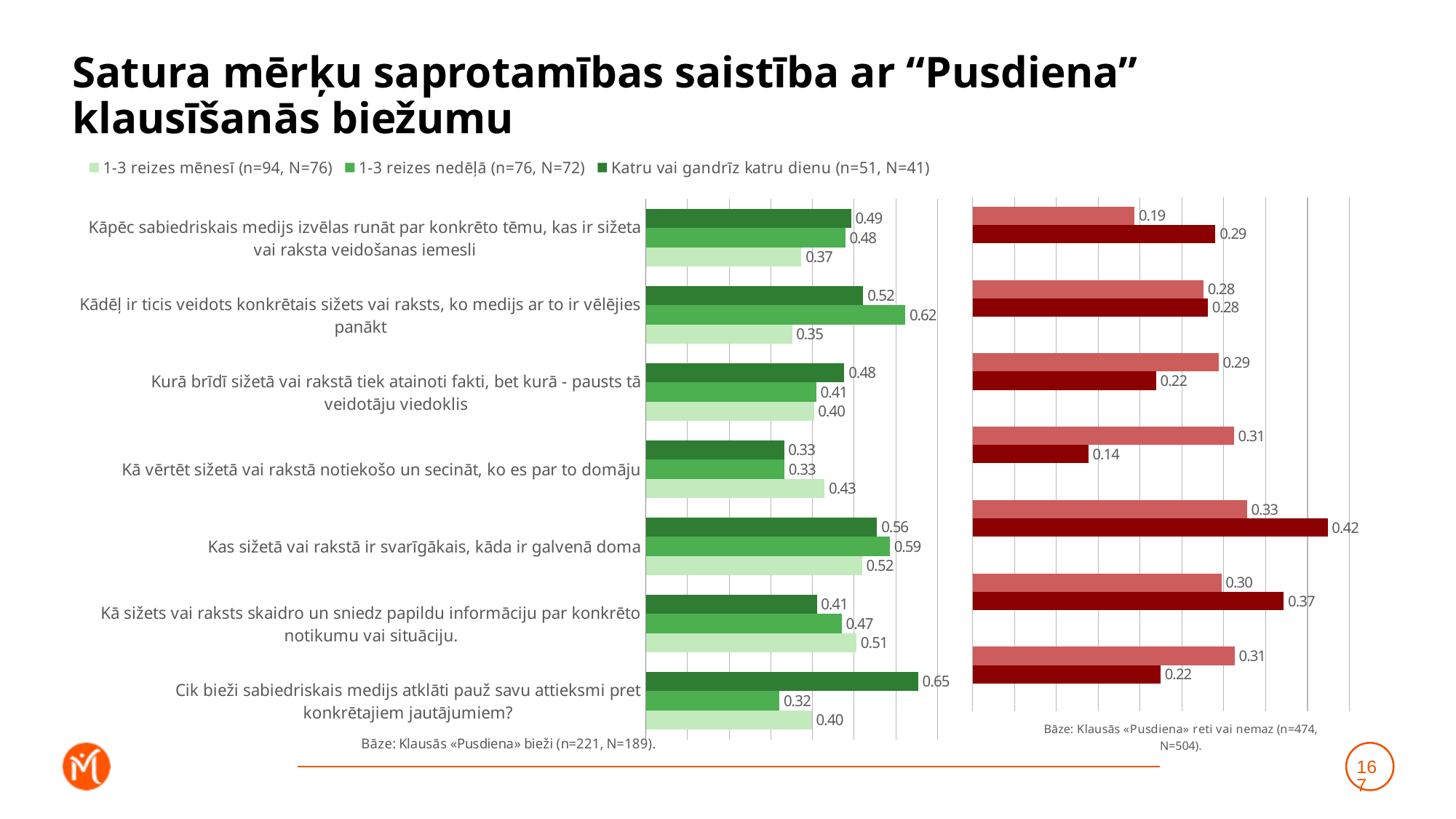
In the left (green) chart, which category has the lowest value for the '1-3 reizes nedēļā' series? Cik bieži sabiedriskais medijs atklāti pauž savu attieksmi pret konkrētajiem jautājumiem? In the left (green) chart, for 'Kādēļ ir ticis veidots konkrētais sižets vai raksts, ko medijs ar to ir vēlējies panākt', what is the difference between the '1-3 reizes nedēļā' value and the '1-3 reizes mēnesī' value? 0.27 What type of chart is used on this slide? Bar chart In the left (green) chart, what is the value for 'Katru vai gandrīz katru dienu' for 'Cik bieži sabiedriskais medijs atklāti pauž savu attieksmi pret konkrētajiem jautājumiem?'? 0.65 In the left (green) chart, which category has the highest value for the 'Katru vai gandrīz katru dienu' series? Cik bieži sabiedriskais medijs atklāti pauž savu attieksmi pret konkrētajiem jautājumiem? In the left (green) chart, what is the value for '1-3 reizes mēnesī' for 'Kā vērtēt sižetā vai rakstā notiekošo un secināt, ko es par to domāju'? 0.43 How many series does the legend of the left (green) chart list? 3 In the left (green) chart, for 'Kas sižetā vai rakstā ir svarīgākais, kāda ir galvenā doma', which series has the larger value: '1-3 reizes nedēļā' or 'Katru vai gandrīz katru dienu'? 1-3 reizes nedēļā How many categories (statements) are shown in the left (green) chart? 7 In the right (red) chart, which category has the highest value among the darker red bars? Kas sižetā vai rakstā ir svarīgākais, kāda ir galvenā doma In the right (red) chart, what is the value of the darker red bar for 'Kas sižetā vai rakstā ir svarīgākais, kāda ir galvenā doma'? 0.42 According to the base note under the left (green) chart, what is the n value for 'Klausās «Pusdiena» bieži'? 221